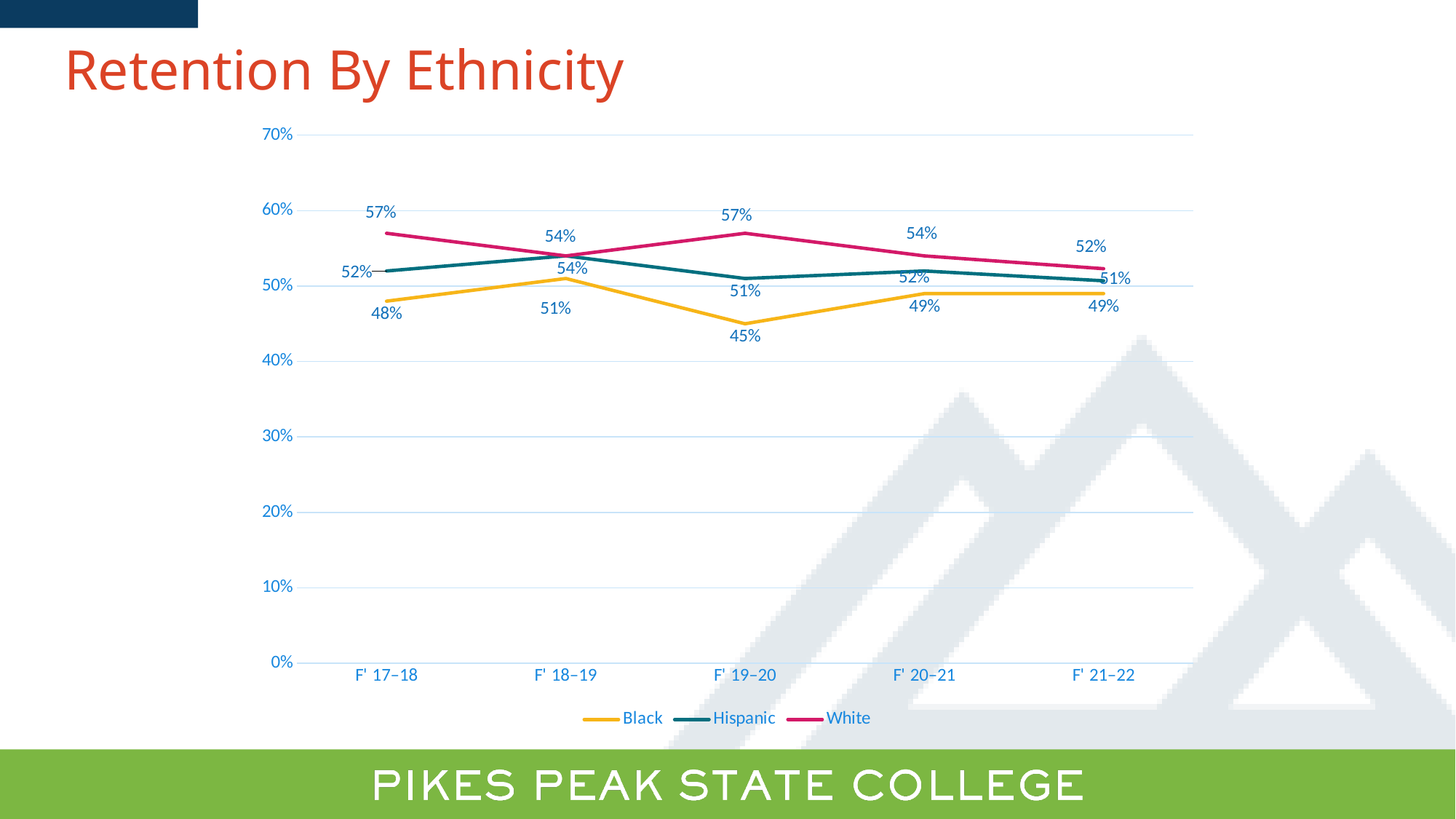
In which term is the retention rate for Black students highest? F' 18–19 What type of chart is shown on the slide? line chart What is the difference between the White and Black retention rates in F' 19–20? 12% How many series does the legend list? 3 What is the retention rate for White students in F' 17–18? 57% Which series has the higher retention rate in F' 20–21, Hispanic or Black? Hispanic Does the retention rate for White students rise or fall from F' 20–21 to F' 21–22? fall What is the title of the chart? Retention By Ethnicity What is the retention rate for Black students in F' 19–20? 45% What is the retention rate for Hispanic students in F' 21–22? 51% In which term is the retention rate for Black students lowest? F' 19–20 How many terms are shown on the x axis? 5